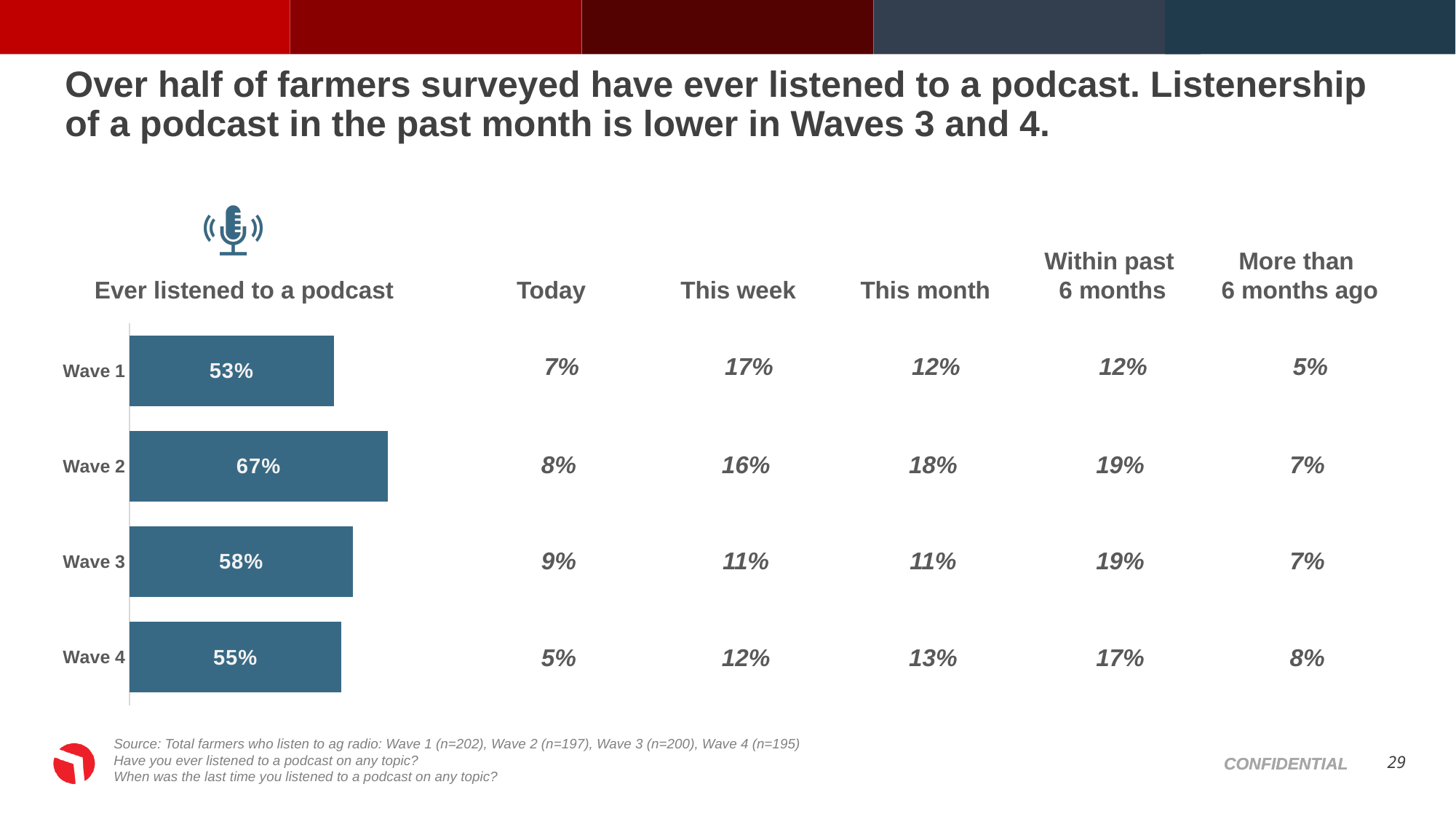
What is the title of the bar chart on the slide? Ever listened to a podcast Which wave has the lowest value in the "Ever listened to a podcast" chart? Wave 1 What kind of chart is the "Ever listened to a podcast" chart? Bar chart What is the value for Wave 2 in the "Ever listened to a podcast" chart? 67% In the "Ever listened to a podcast" chart, which is larger, the value for Wave 3 or the value for Wave 4? Wave 3 What is the difference between the Wave 2 and Wave 1 values in the "Ever listened to a podcast" chart? 14% How many waves are shown in the "Ever listened to a podcast" chart? 4 What is the value for Wave 4 in the "Ever listened to a podcast" chart? 55% Which wave has the highest value in the "Ever listened to a podcast" chart? Wave 2 What is the value for Wave 1 in the "Ever listened to a podcast" chart? 53% What colour are the bars in the "Ever listened to a podcast" chart? Blue What is the difference between the Wave 3 and Wave 4 values in the "Ever listened to a podcast" chart? 3%